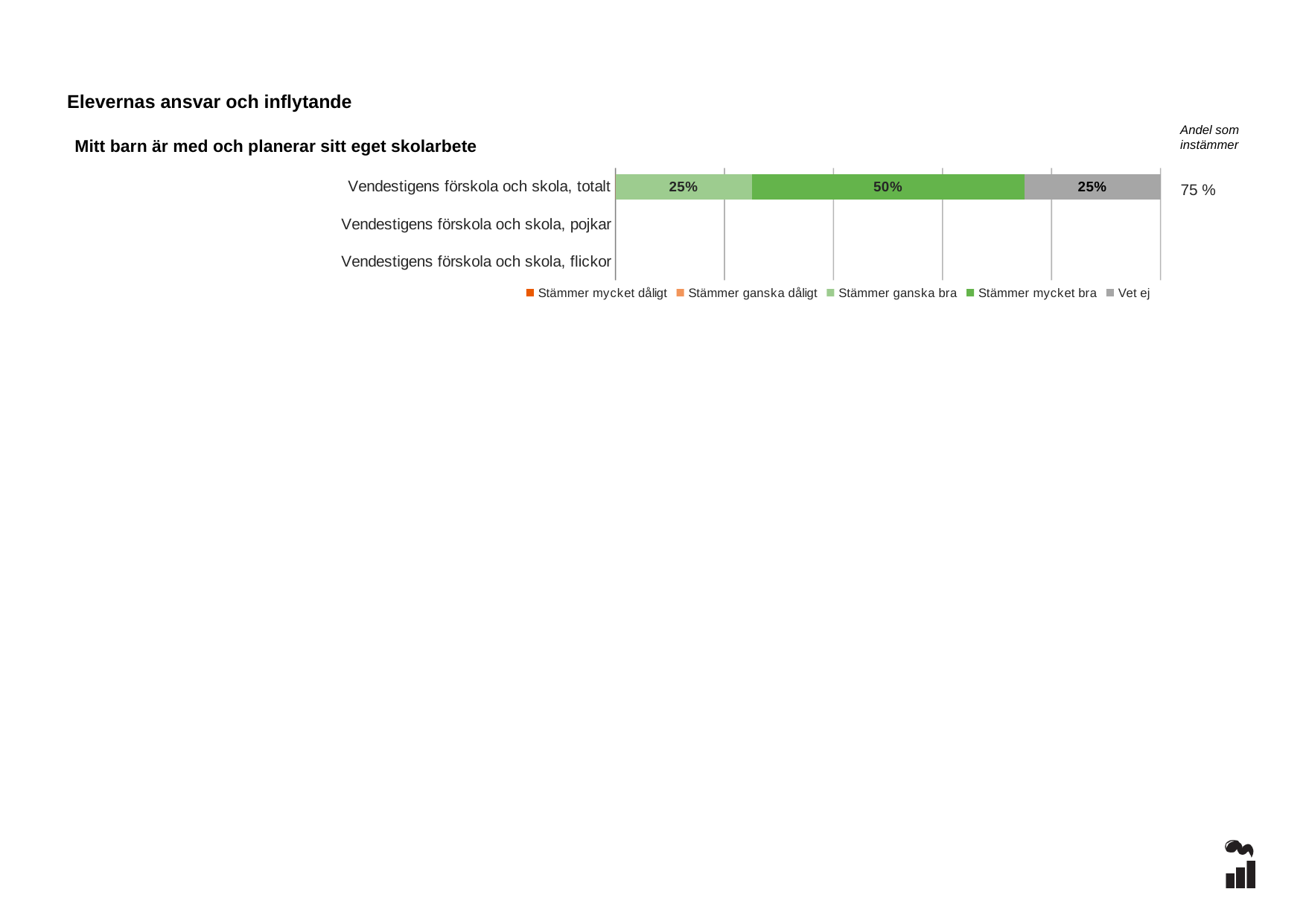
What is the "Andel som instämmer" value shown for "Vendestigens förskola och skola, totalt"? 75 % What kind of chart is shown on the slide? Stacked bar chart What is the value of "Vet ej" for "Vendestigens förskola och skola, totalt"? 25% What is the difference between the "Stämmer mycket bra" and "Vet ej" segments for "Vendestigens förskola och skola, totalt"? 25% What is the title of the chart? Mitt barn är med och planerar sitt eget skolarbete What is the value of "Stämmer mycket bra" for "Vendestigens förskola och skola, totalt"? 50% Which is larger for "Vendestigens förskola och skola, totalt": "Stämmer mycket bra" or "Stämmer ganska bra"? Stämmer mycket bra How many categories are listed on the vertical axis of the chart? 3 Which series has the largest segment in the bar for "Vendestigens förskola och skola, totalt"? Stämmer mycket bra What is the value of "Stämmer ganska bra" for "Vendestigens förskola och skola, totalt"? 25% How many series does the legend list? 5 What is the total of the labelled segments in the bar for "Vendestigens förskola och skola, totalt"? 100%